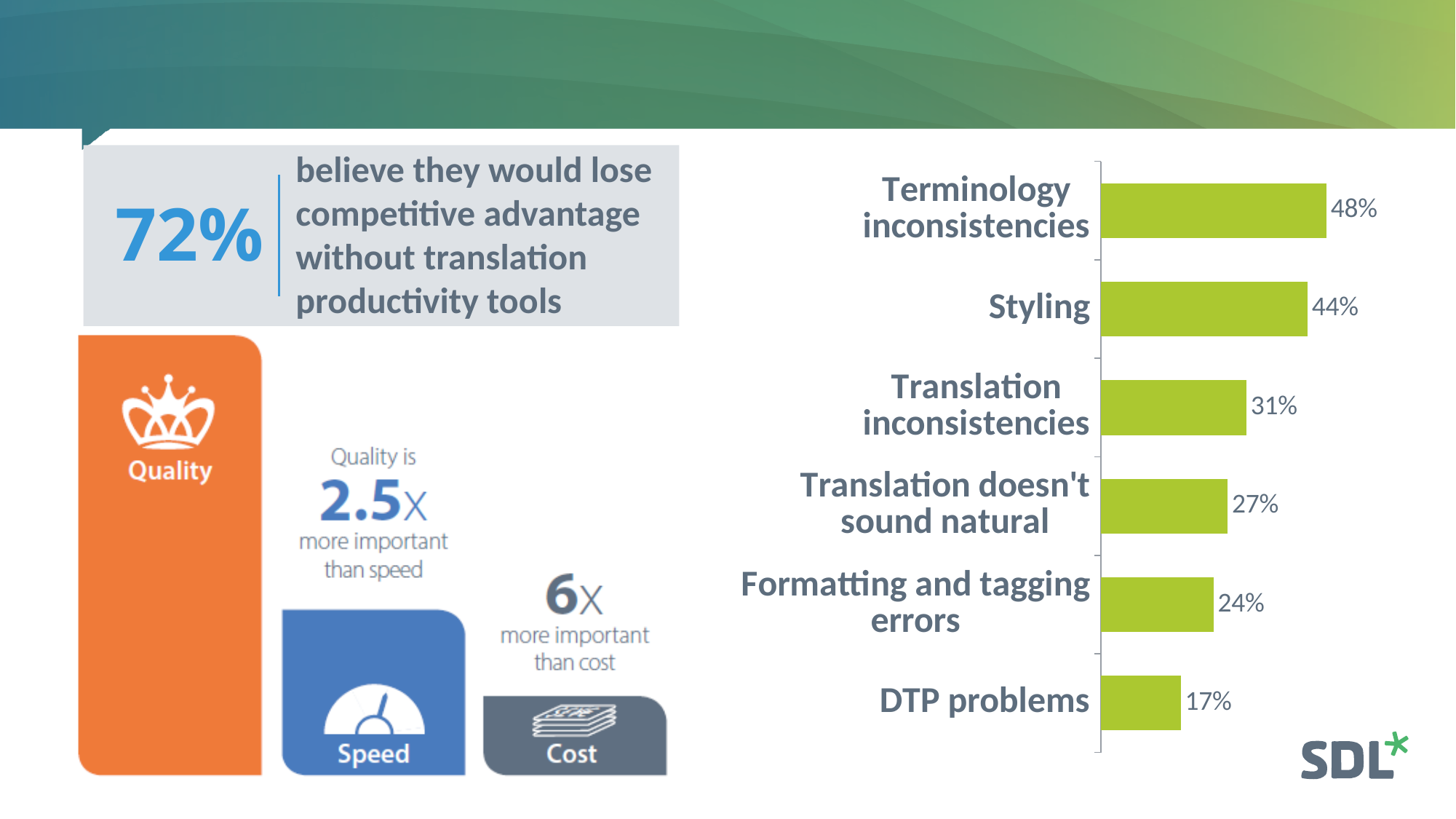
What is the value for DTP problems? 17% What is the difference between the values for Translation doesn't sound natural and Formatting and tagging errors? 3% What is the difference between the values for Terminology inconsistencies and Styling? 4% How many categories are shown in the bar chart? 6 What kind of chart is shown on the right of the slide? Bar chart What is the value for Styling? 44% What is the value for Translation inconsistencies? 31% Which is larger, the value for Translation inconsistencies or the value for Formatting and tagging errors? Translation inconsistencies What is the value for Terminology inconsistencies? 48% What colour are the bars in the chart? Green Which category has the lowest value? DTP problems Which category has the highest value? Terminology inconsistencies